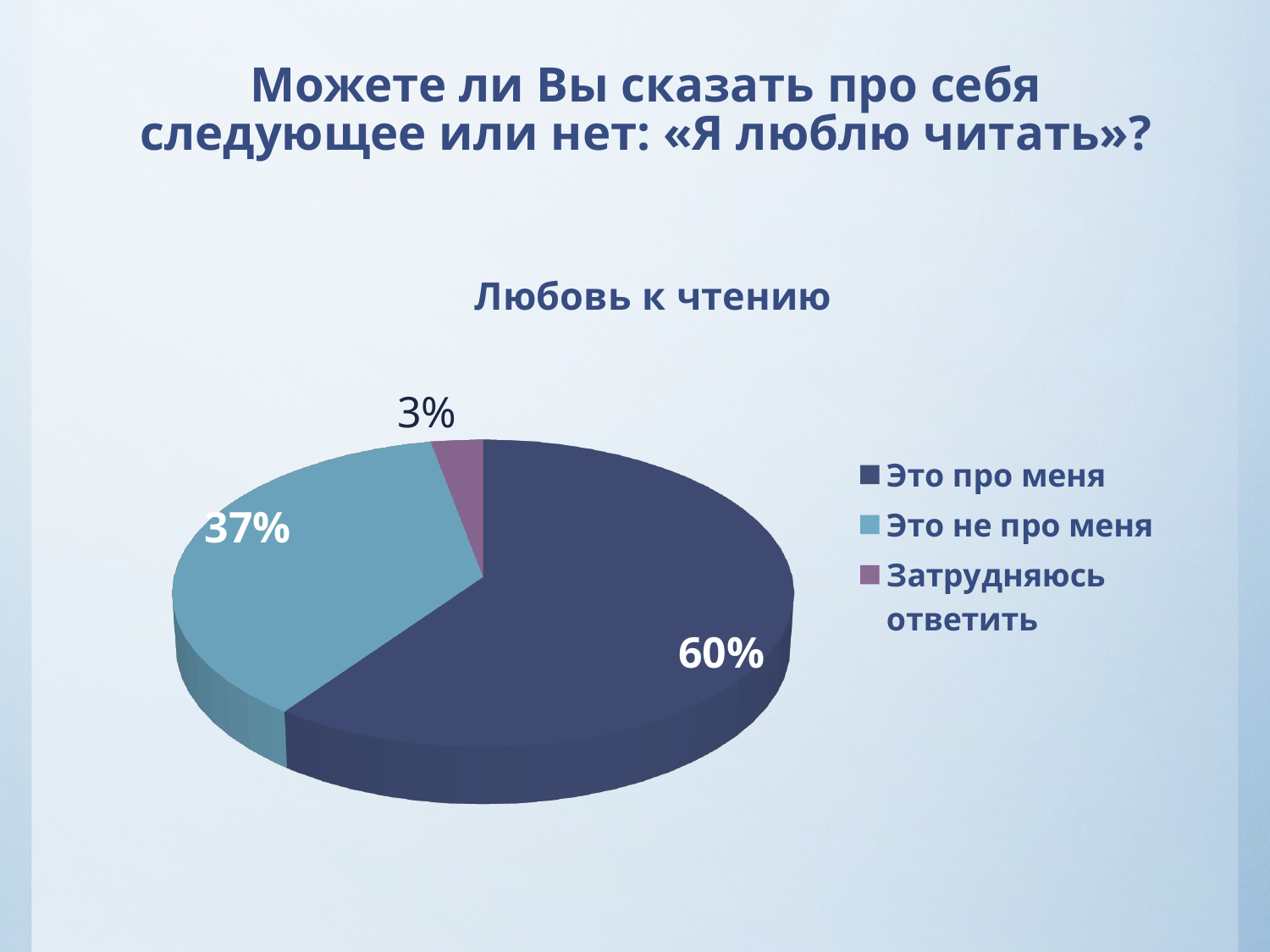
What kind of chart is shown? Pie chart How many slices does the pie have? 3 What is the difference between "Это про меня" and "Это не про меня"? 23% Which category has the largest slice? Это про меня What is the difference between "Это не про меня" and "Затрудняюсь ответить"? 34% Which category has the smallest slice? Затрудняюсь ответить What is the value for "Затрудняюсь ответить"? 3% What is the value for "Это не про меня"? 37% What is the title of the chart? Любовь к чтению What share of the pie does "Это про меня" take? 60% Which is larger, "Это не про меня" or "Затрудняюсь ответить"? Это не про меня Which legend entry is shown in dark blue? Это про меня